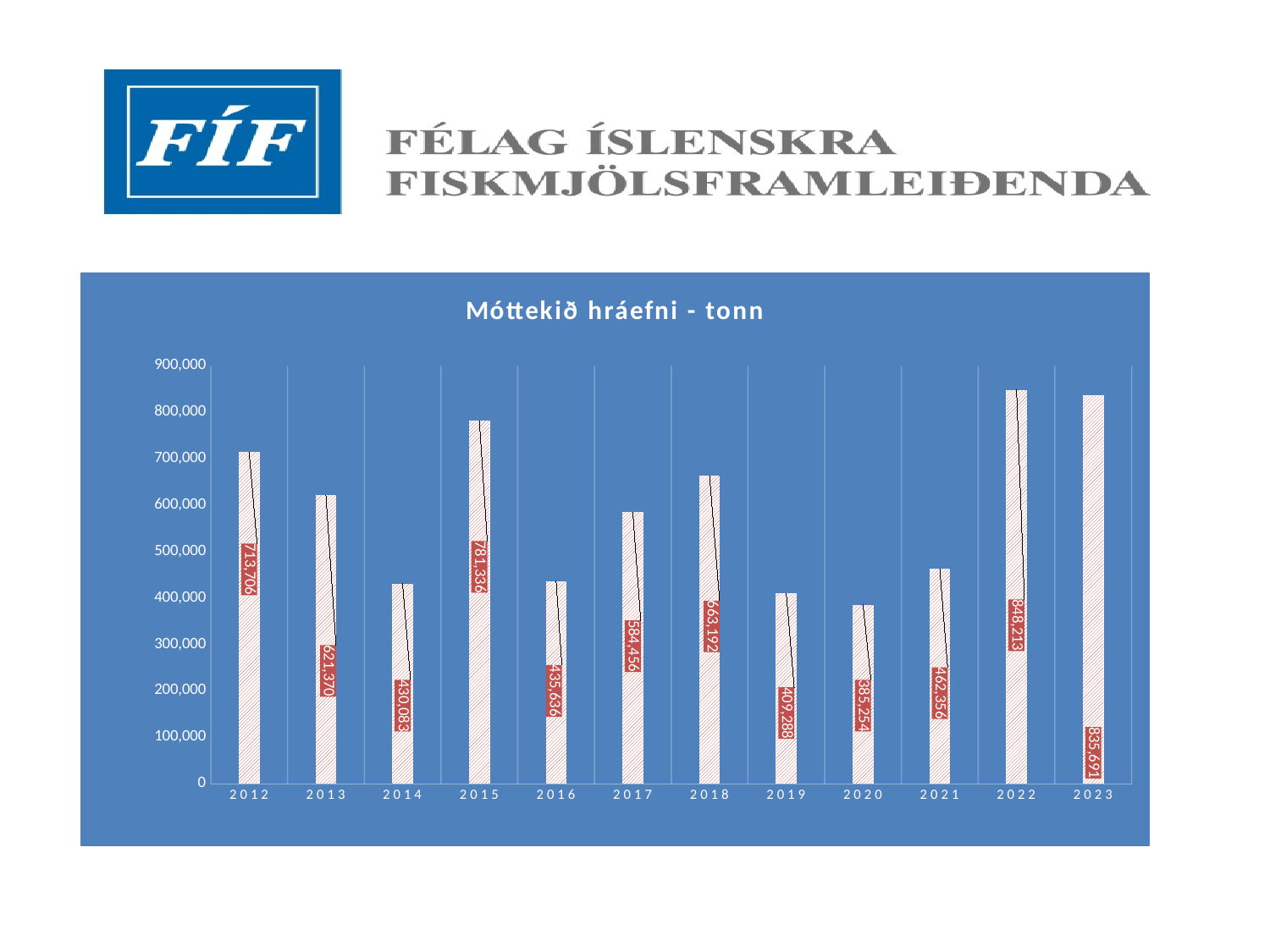
How many years are shown on the x axis? 12 Which year has the lowest value? 2020 Which year has the highest value? 2022 Which is larger, the value for 2013 or the value for 2017? 2013 What is the value for 2020? 385,254 What is the value for 2018? 663,192 What is the value for 2012? 713,706 What is the value for 2023? 835,691 What is the title of the chart? Móttekið hráefni - tonn What is the difference between the values for 2015 and 2012? 67,630 What is the difference between the values for 2022 and 2023? 12,522 Is the value for 2021 greater or less than 500,000? less